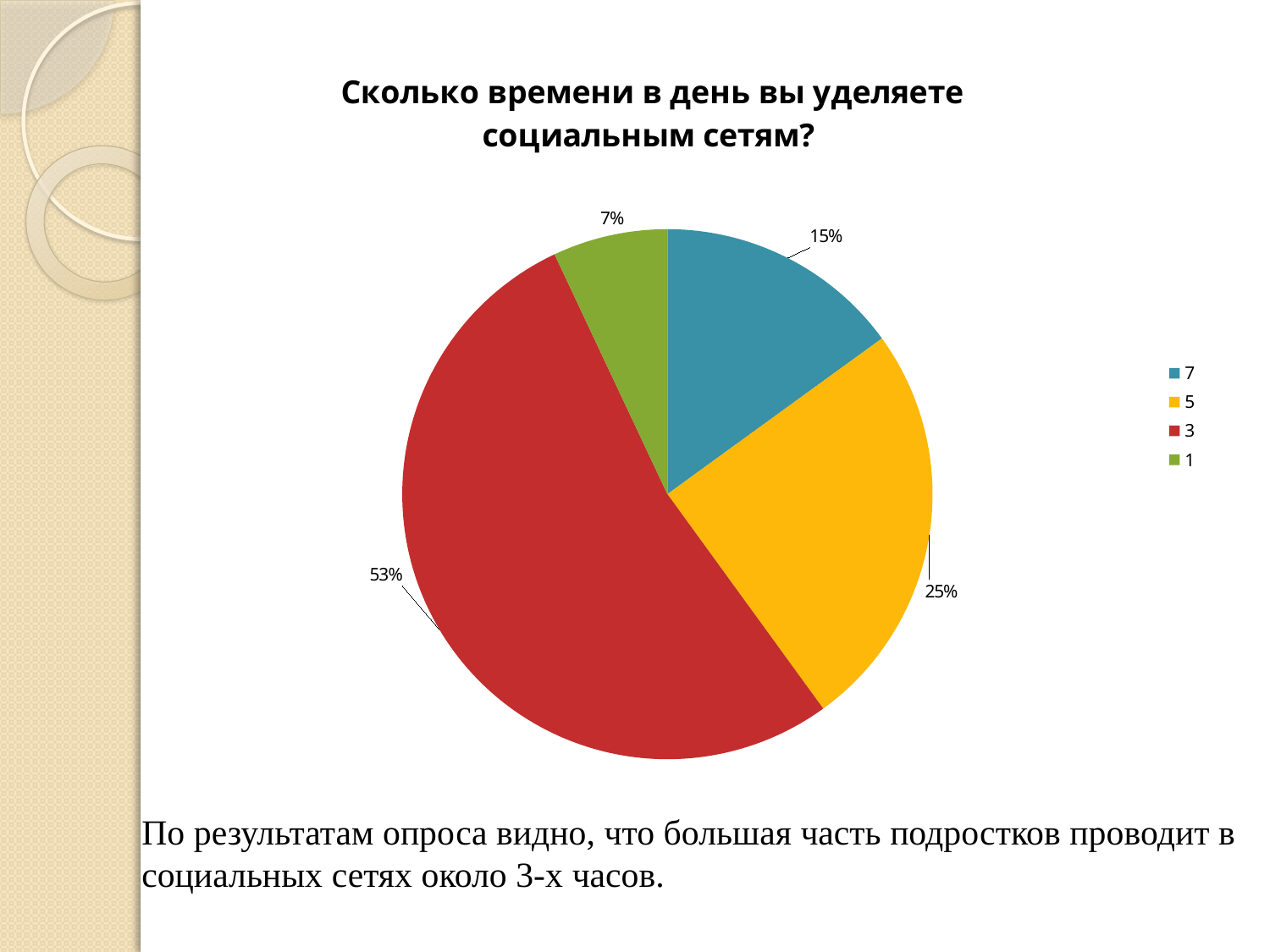
Which category has the smallest slice of the pie? 1 How many slices does the pie chart have? 4 What kind of chart is shown on the slide? pie chart Which slice is larger, the one for "7" or the one for "5"? 5 What is the difference in percentage points between the slices for "3" and "5"? 28 What share of the pie does the category "5" take? 25% What is the title of the chart? Сколько времени в день вы уделяете социальным сетям? Which category has the largest slice of the pie? 3 What share of the pie does the category "3" take? 53% How many entries does the legend list? 4 What share of the pie does the category "1" take? 7%